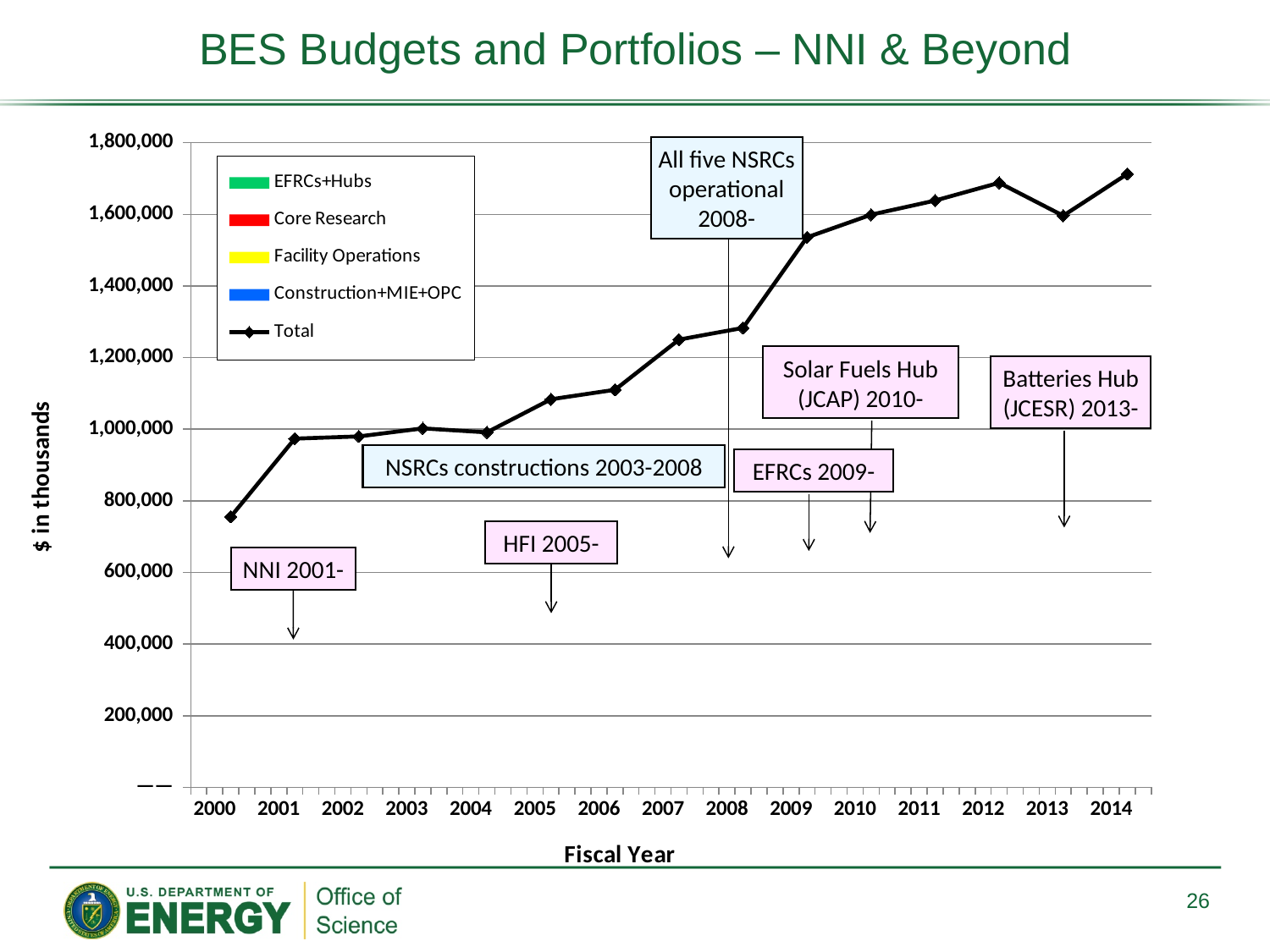
Which fiscal year has the lowest Total value? 2000 How many fiscal years are plotted on the x axis? 15 How many series does the legend list? 5 Which fiscal year has the highest Total value? 2014 Is the Total value for 2006 greater or less than 1,200,000? less Is the Total value for 2007 greater or less than 1,200,000? greater Is the Total value for 2000 greater or less than 800,000? less Does the Total line generally rise or fall from 2000 to 2014? rise Which has the larger Total value, 2012 or 2013? 2012 What kind of chart is shown on the slide? line chart What is the title of the x axis? Fiscal Year